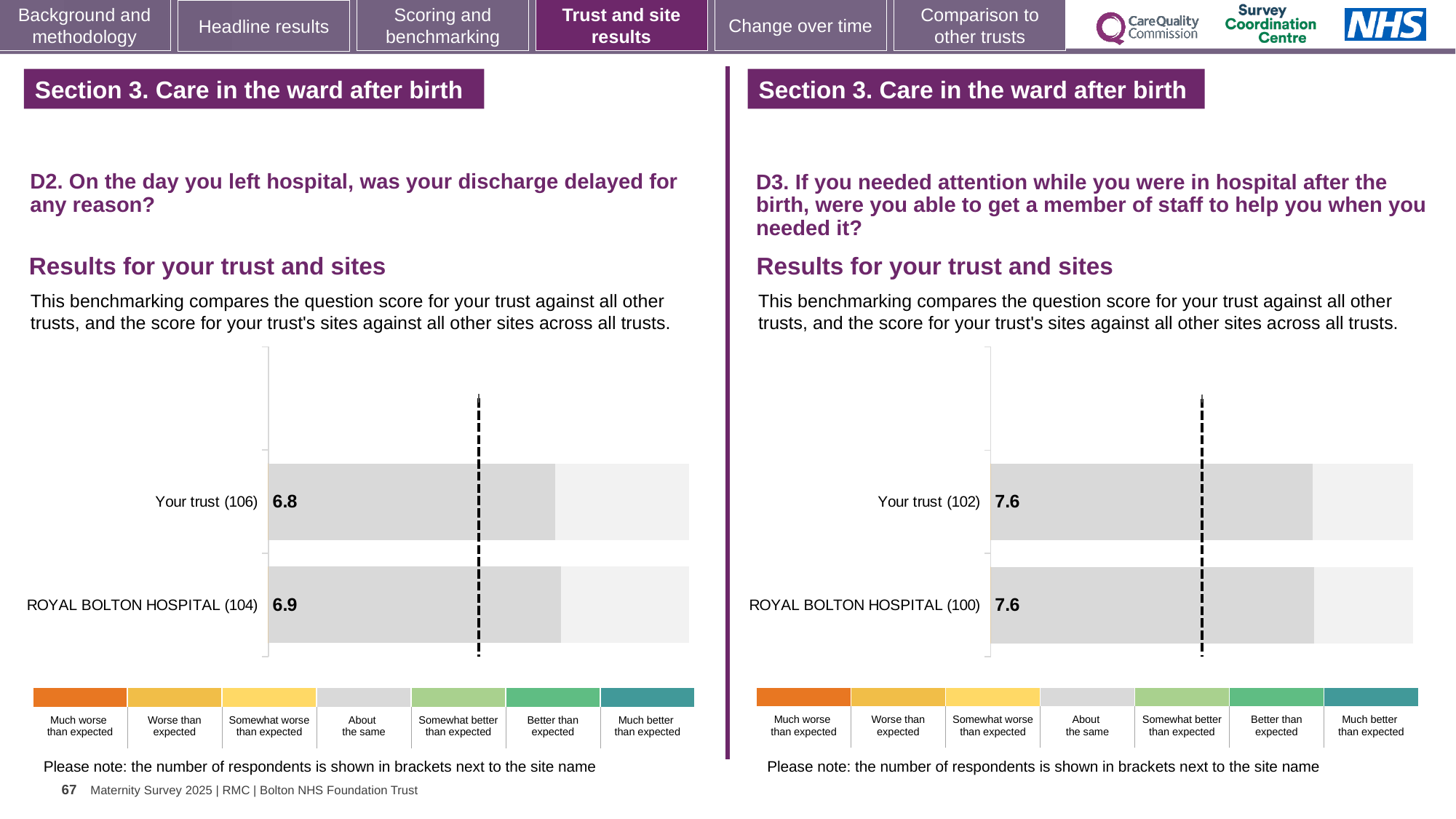
On the D2 chart (left), what is the difference between the ROYAL BOLTON HOSPITAL score and the Your trust score? 0.1 On the D2 chart (left), which category has the lowest score? Your trust On the D2 chart (left), what is the score for Your trust? 6.8 On the D2 chart (left), how many respondents are shown in brackets for Your trust? 106 On the D2 chart (left), which has the higher score, Your trust or ROYAL BOLTON HOSPITAL? ROYAL BOLTON HOSPITAL On the D3 chart (right), what is the score for ROYAL BOLTON HOSPITAL? 7.6 On the D2 chart (left), what is the score for ROYAL BOLTON HOSPITAL? 6.9 On the D3 chart (right), how many respondents are shown in brackets for ROYAL BOLTON HOSPITAL? 100 How many bars are plotted on the D2 chart (left)? 2 On the D3 chart (right), what is the difference between the Your trust score and the ROYAL BOLTON HOSPITAL score? 0 On the D3 chart (right), what is the score for Your trust? 7.6 What type of chart is used on the D3 chart (right)? Bar chart